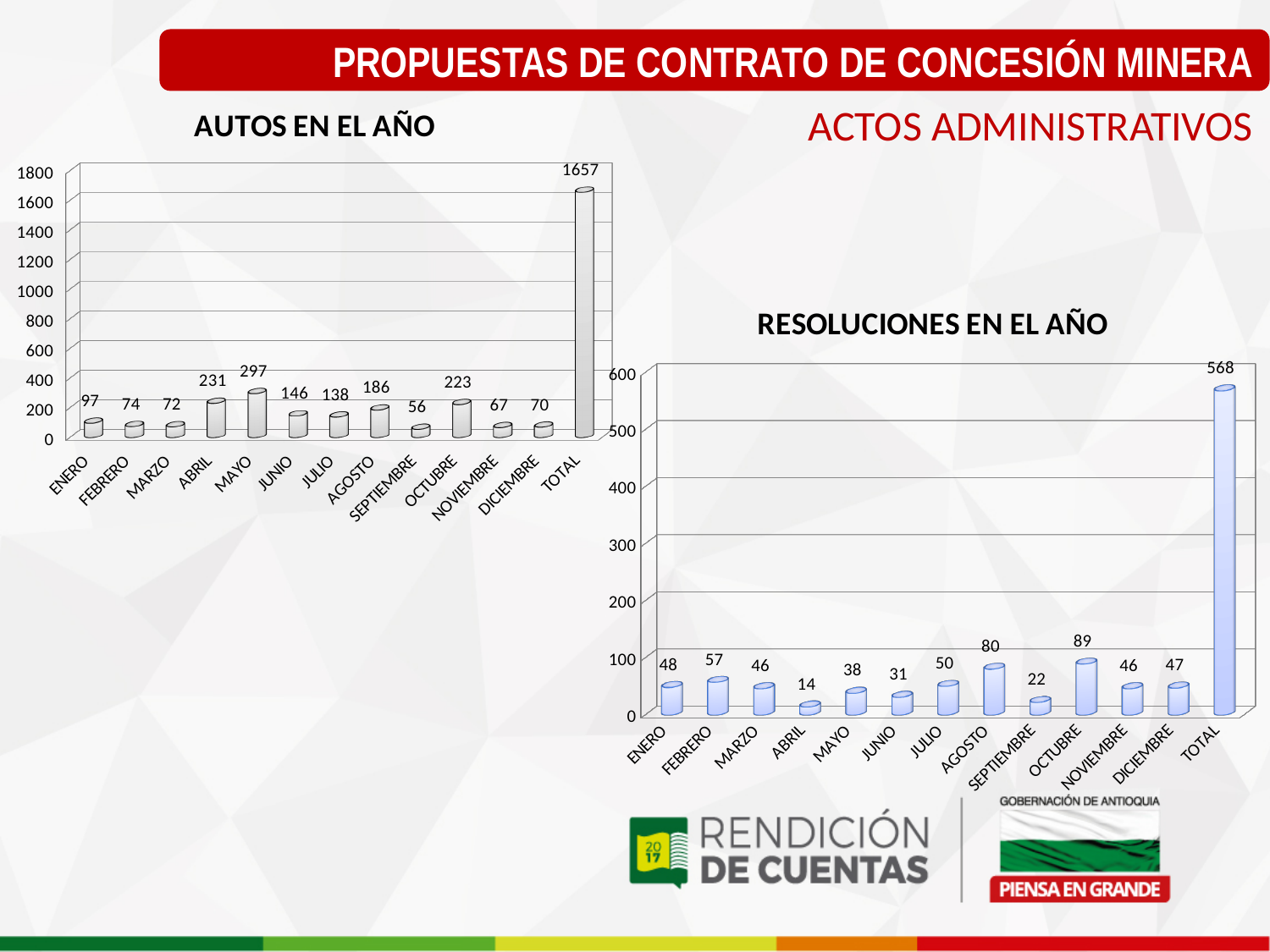
In the 'RESOLUCIONES EN EL AÑO' chart, what is the value for AGOSTO? 80 In the 'AUTOS EN EL AÑO' chart, what is the value for TOTAL? 1657 How many categories are shown on the x axis of the 'RESOLUCIONES EN EL AÑO' chart? 13 In the 'RESOLUCIONES EN EL AÑO' chart, which is larger, the value for FEBRERO or the value for JULIO? FEBRERO In the 'AUTOS EN EL AÑO' chart, which month has the lowest value? SEPTIEMBRE What kind of chart is 'AUTOS EN EL AÑO'? Bar chart In the 'AUTOS EN EL AÑO' chart, what is the difference between the values for ABRIL and OCTUBRE? 8 In the 'RESOLUCIONES EN EL AÑO' chart, which month has the lowest value? ABRIL In the 'RESOLUCIONES EN EL AÑO' chart, what is the difference between the TOTAL value and the value for OCTUBRE? 479 In the 'AUTOS EN EL AÑO' chart, which month has the highest value? MAYO In the 'AUTOS EN EL AÑO' chart, what is the value for MAYO? 297 In the 'RESOLUCIONES EN EL AÑO' chart, which month has the highest value? OCTUBRE